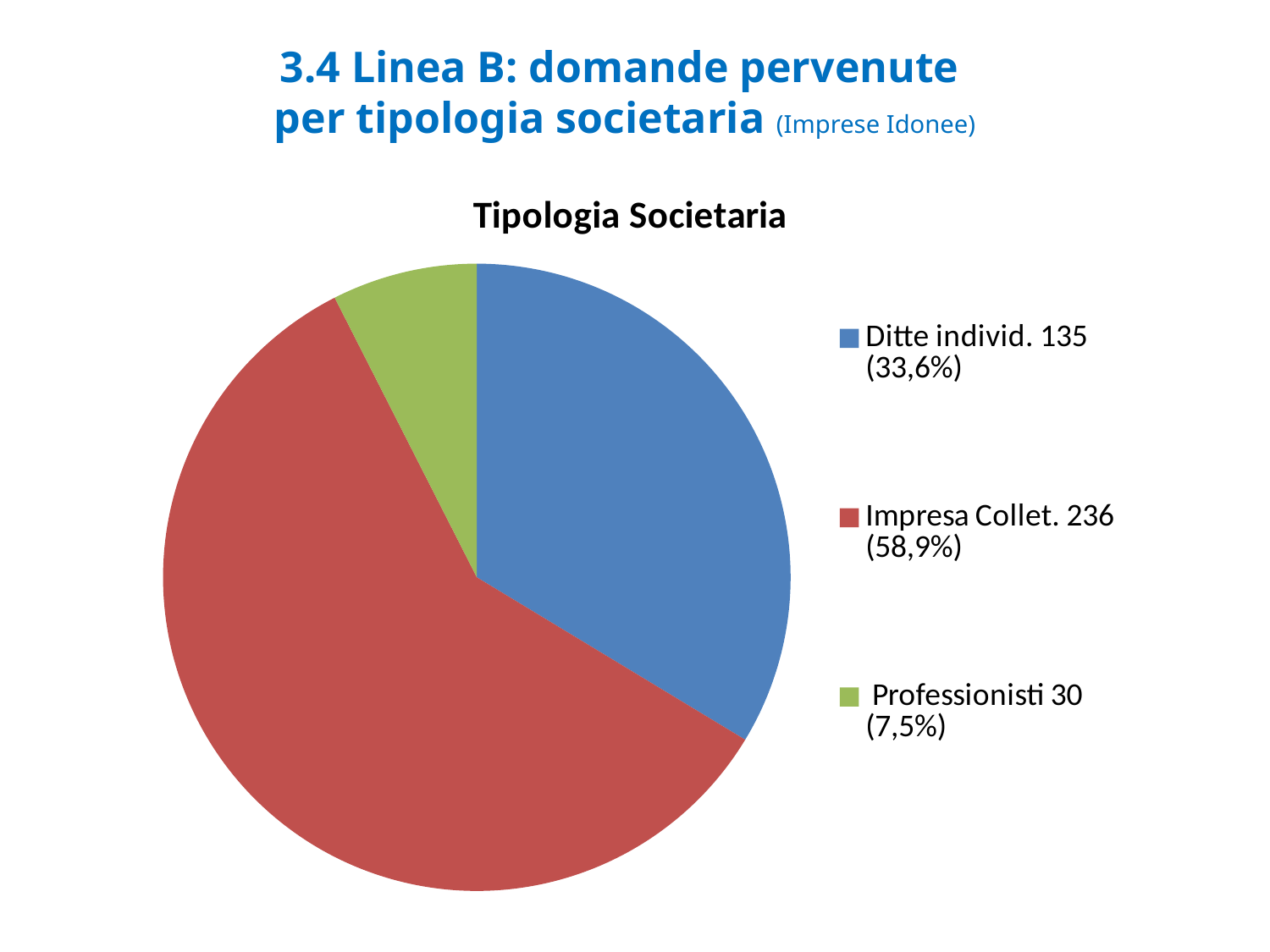
What is the difference between the Impresa Collet. and Ditte individ. values? 101 How many slices does the pie chart have? 3 How many applications are from Professionisti? 30 What kind of chart is shown on the slide? pie chart How many applications are from Impresa Collet.? 236 How many entries does the legend list? 3 How many applications are from Ditte individ.? 135 Which category has the largest slice of the pie? Impresa Collet. Which colour represents Professionisti in the pie chart? green Which category has the smallest slice of the pie? Professionisti What is the chart's title? Tipologia Societaria What share of the pie does Ditte individ. represent? 33,6%